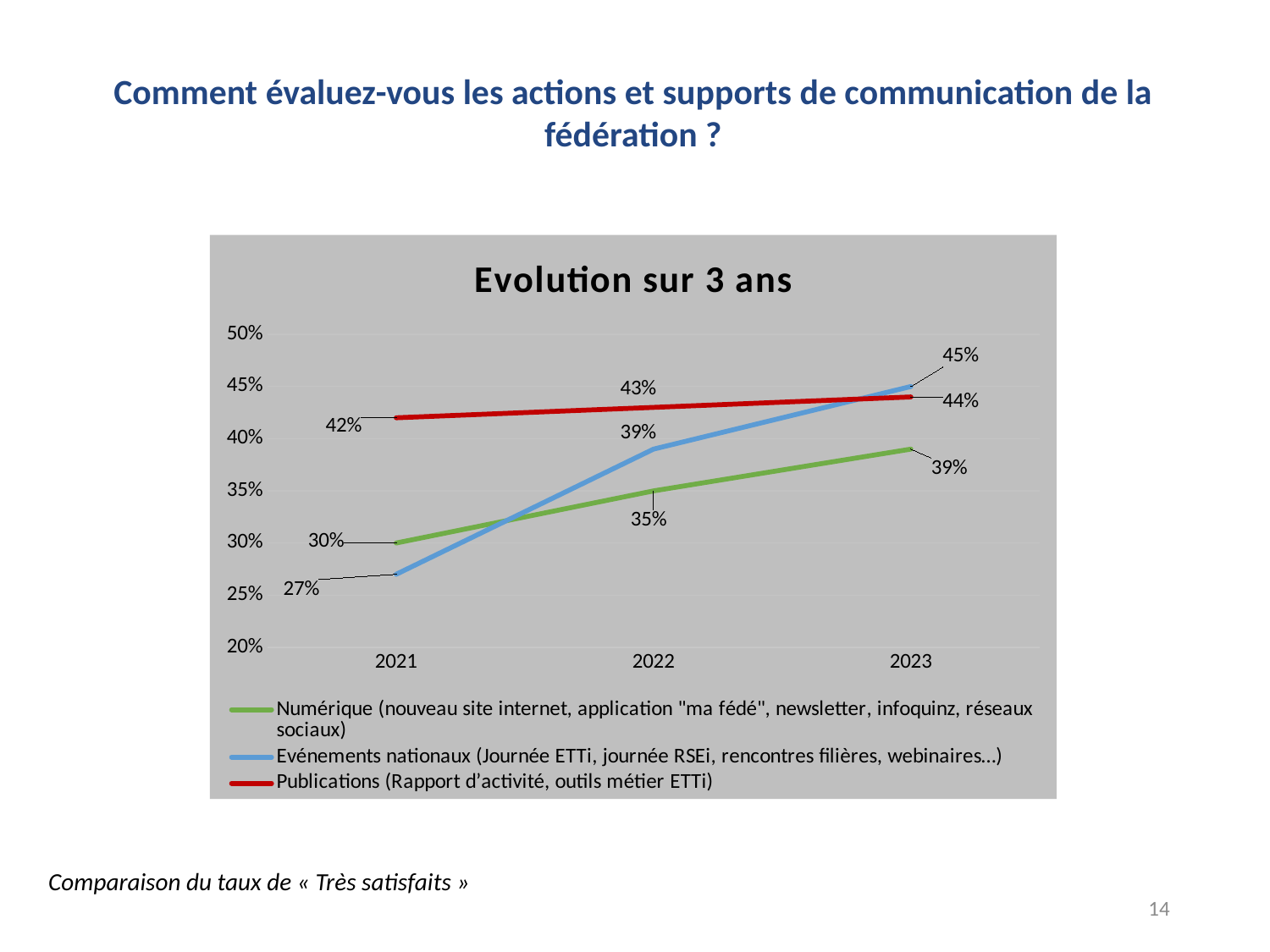
Which series has the highest value in 2023? Evénements nationaux What is the value for Numérique in 2022? 35% What is the value for Evénements nationaux in 2021? 27% What is the title of the chart? Evolution sur 3 ans Which is larger in 2022, the value for Publications or the value for Numérique? Publications How many series does the legend list? 3 What is the difference between the Evénements nationaux values in 2023 and 2021? 18% Does the Numérique series rise or fall from 2021 to 2023? rise Which series has the lowest value in 2021? Evénements nationaux What type of chart is shown on the slide? line chart How many years are shown on the x axis? 3 What is the value for Publications in 2023? 44%